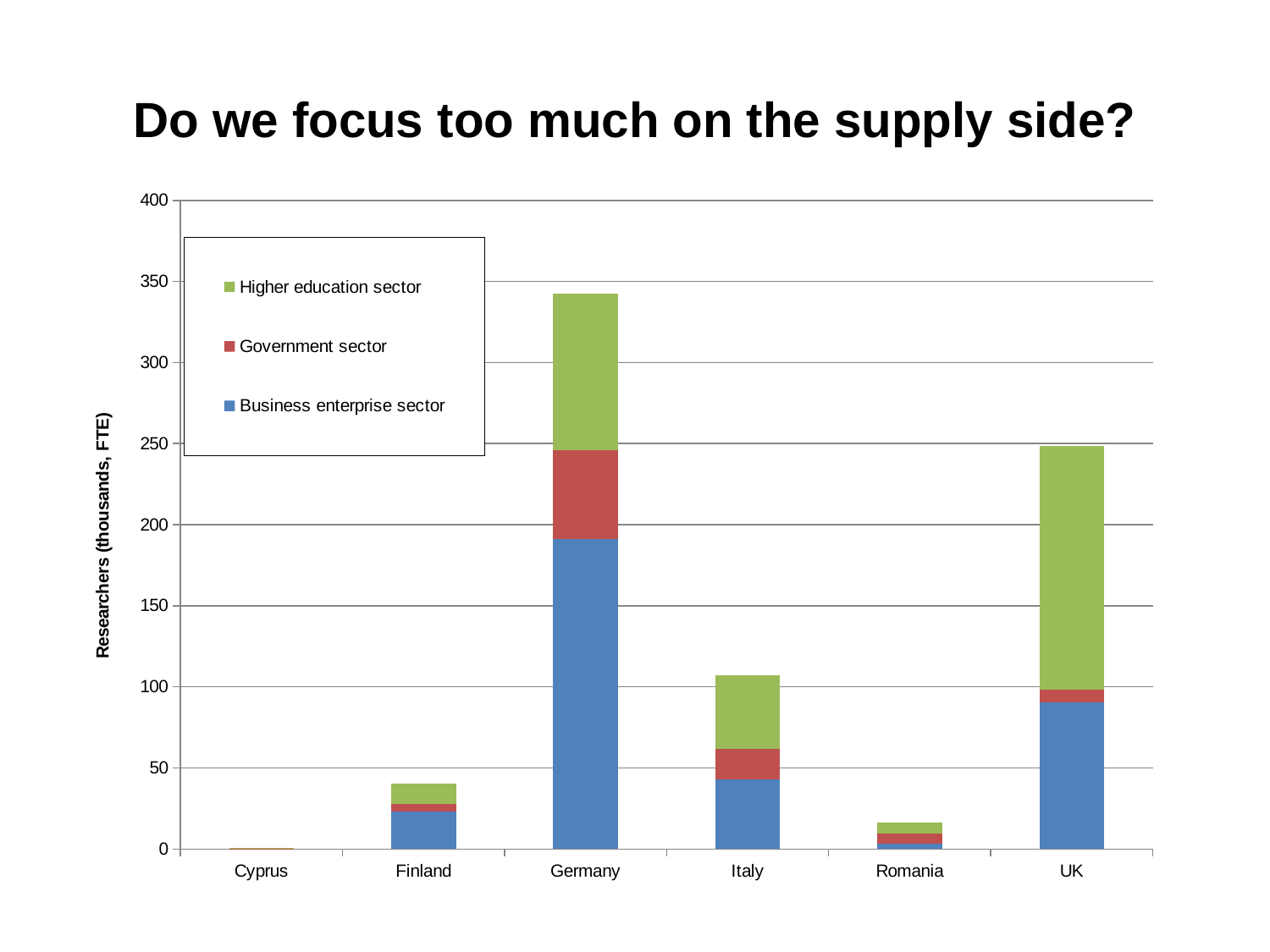
Is the total stacked bar for Italy greater or less than 150? less Is the total stacked bar for the UK greater or less than 200? greater Which country has a taller stacked bar, Finland or Romania? Finland Is the total stacked bar for Germany greater or less than 300? greater Which country has a taller stacked bar, the UK or Italy? UK What is the label on the vertical axis of the chart? Researchers (thousands, FTE) What kind of chart is shown on the slide? Stacked bar chart Which country has the tallest stacked bar in the chart? Germany Which country has the shortest stacked bar in the chart? Cyprus How many countries are shown on the x axis of the chart? 6 How many series does the chart's legend list? 3